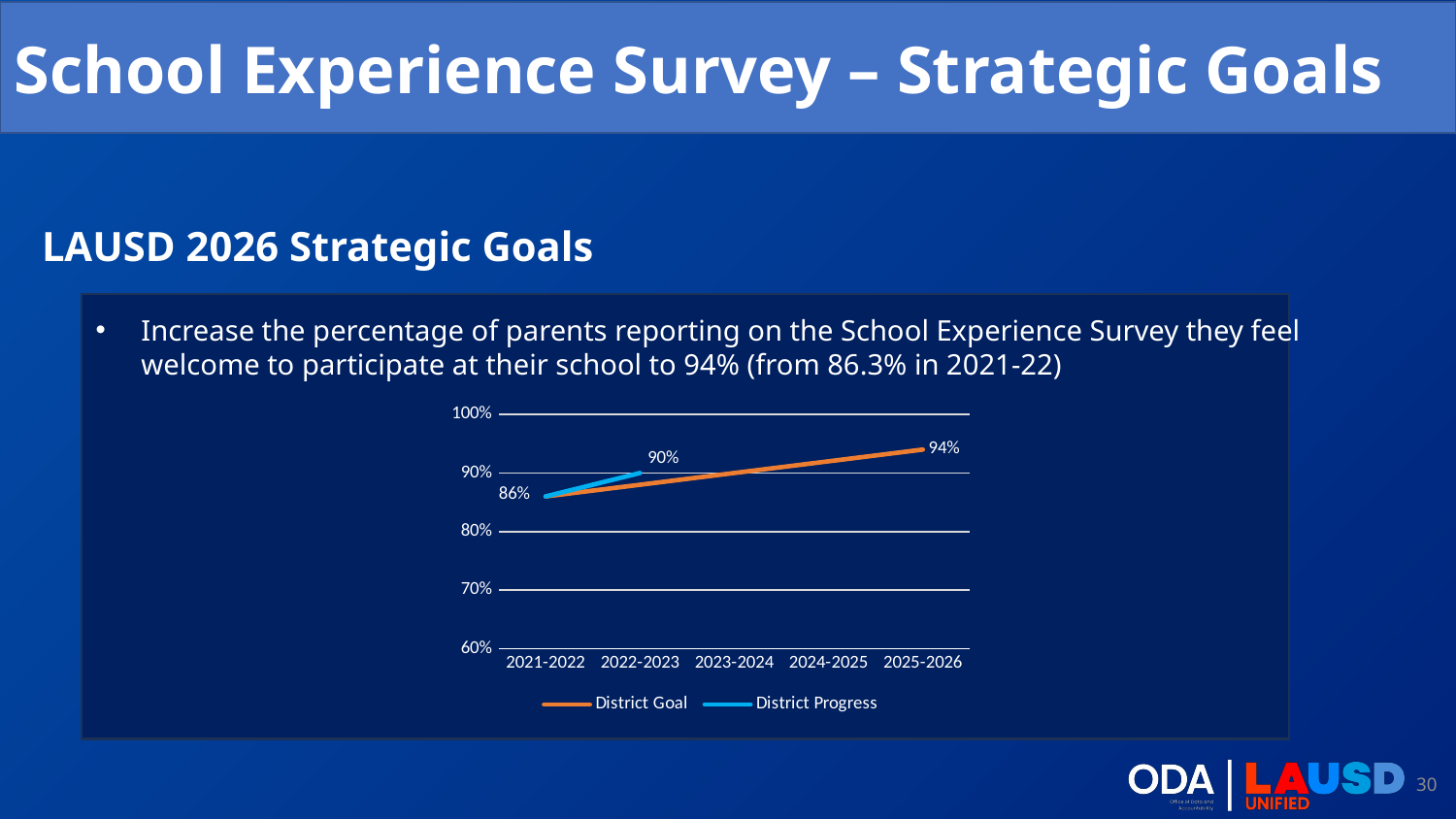
How many series does the chart legend list? 2 How many school years are shown on the x axis of the chart? 5 What is the District Goal value for 2025-2026? 94% What is the difference between the District Goal value for 2025-2026 and the value for 2021-2022? 8 percentage points What kind of chart is shown on the slide? line chart Does the District Goal line rise or fall from 2021-2022 to 2025-2026? rise What is the District Progress value for 2022-2023? 90% Which is larger: the District Progress value for 2022-2023 or the District Goal value for 2025-2026? District Goal value for 2025-2026 Is the District Goal value for 2023-2024 greater or less than 80%? greater What is the difference between the District Progress value for 2022-2023 and the value for 2021-2022? 4 percentage points What value is labelled at 2021-2022 on the chart? 86% What colour is the District Goal line in the chart? orange